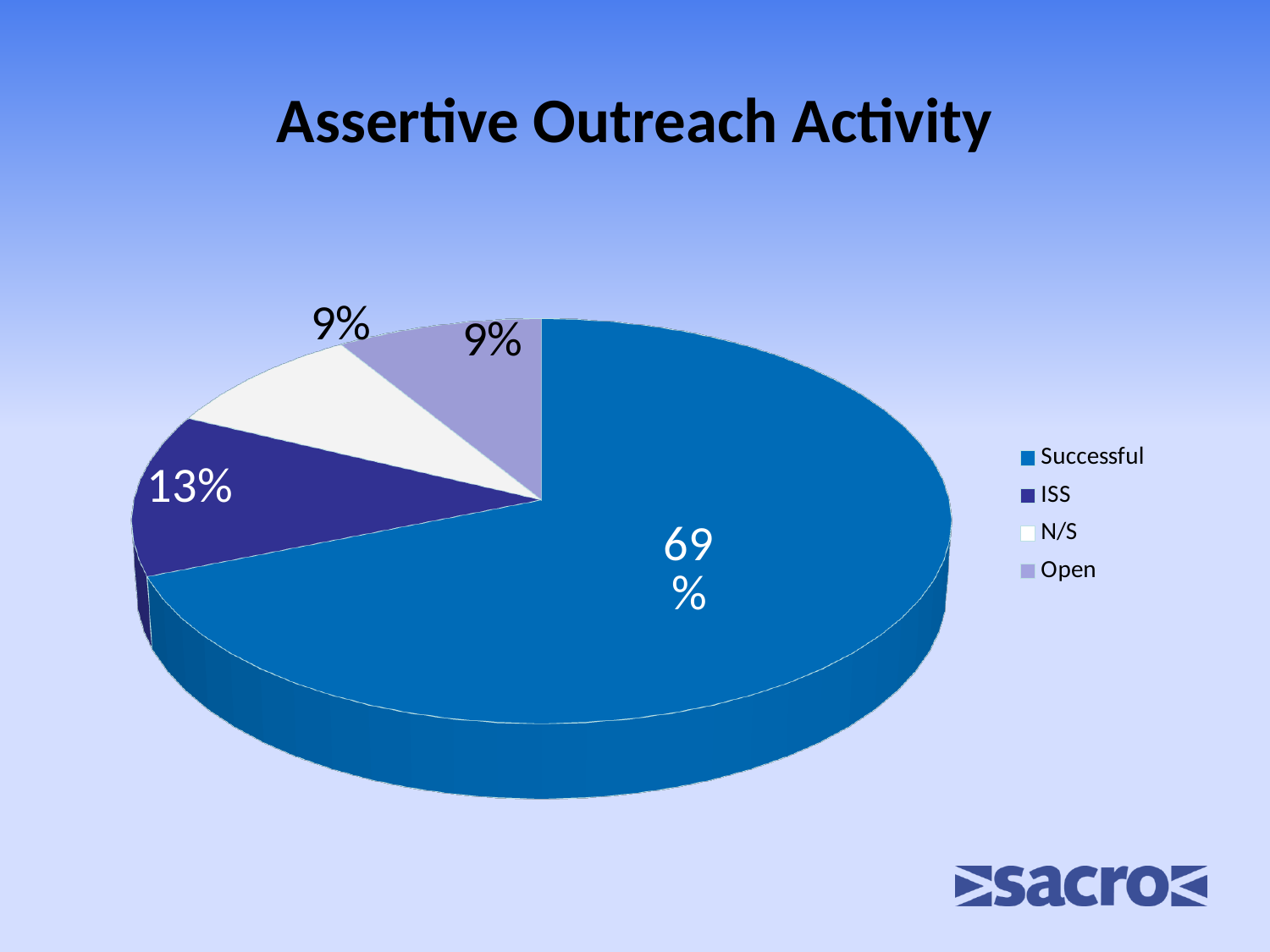
Which is larger, the ISS slice or the Open slice? ISS What kind of chart is shown on the slide? Pie chart Which legend entry is shown in white? N/S How many categories does the pie chart show? 4 What is the difference in percentage points between the Successful slice and the ISS slice? 56 What share of the pie does the Open slice represent? 9% What is the title of the chart? Assertive Outreach Activity What share of the pie does the N/S slice represent? 9% What share of the pie does the ISS slice represent? 13% Which category has the largest slice of the pie? Successful Is the Successful slice greater or less than 50% of the pie? greater